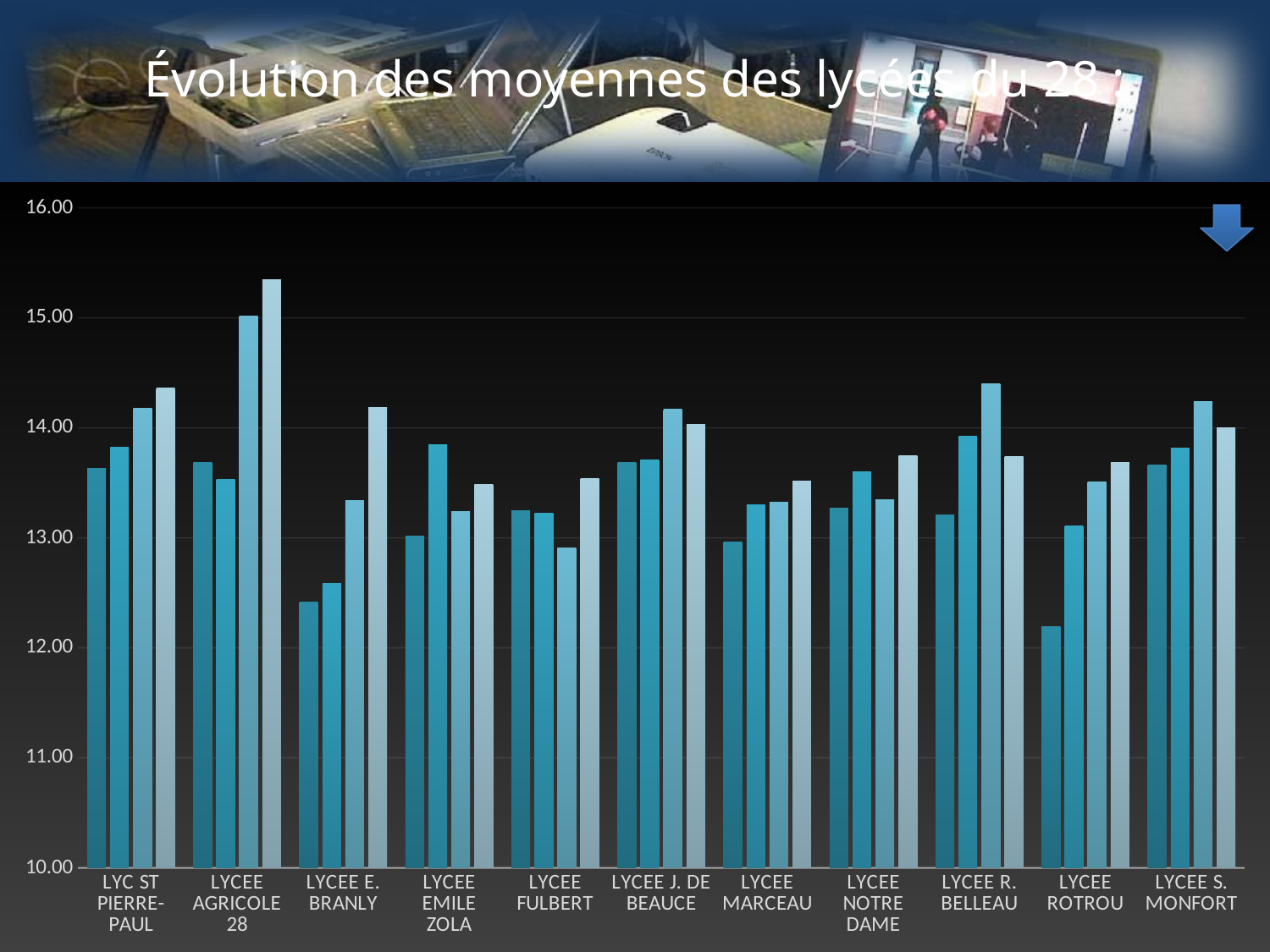
Is the first (leftmost) bar for LYCEE ROTROU greater or less than 13.00? less Do the four bars for LYC ST PIERRE-PAUL rise or fall from left to right? rise Which lycée has the tallest bar in the chart? LYCEE AGRICOLE 28 Which is taller: the fourth bar for LYCEE AGRICOLE 28 or the fourth bar for LYC ST PIERRE-PAUL? LYCEE AGRICOLE 28 How many lycées (categories) are shown on the x axis of the chart? 11 Is the first (leftmost) bar for LYCEE E. BRANLY greater or less than 13.00? less What kind of chart is shown on the slide? bar chart Is the tallest bar for LYCEE AGRICOLE 28 greater or less than 15.00? greater How many bars are plotted for each lycée in the chart? 4 What is the highest value shown on the vertical axis of the chart? 16.00 What is the title of the chart on the slide? Évolution des moyennes des lycées du 28 :